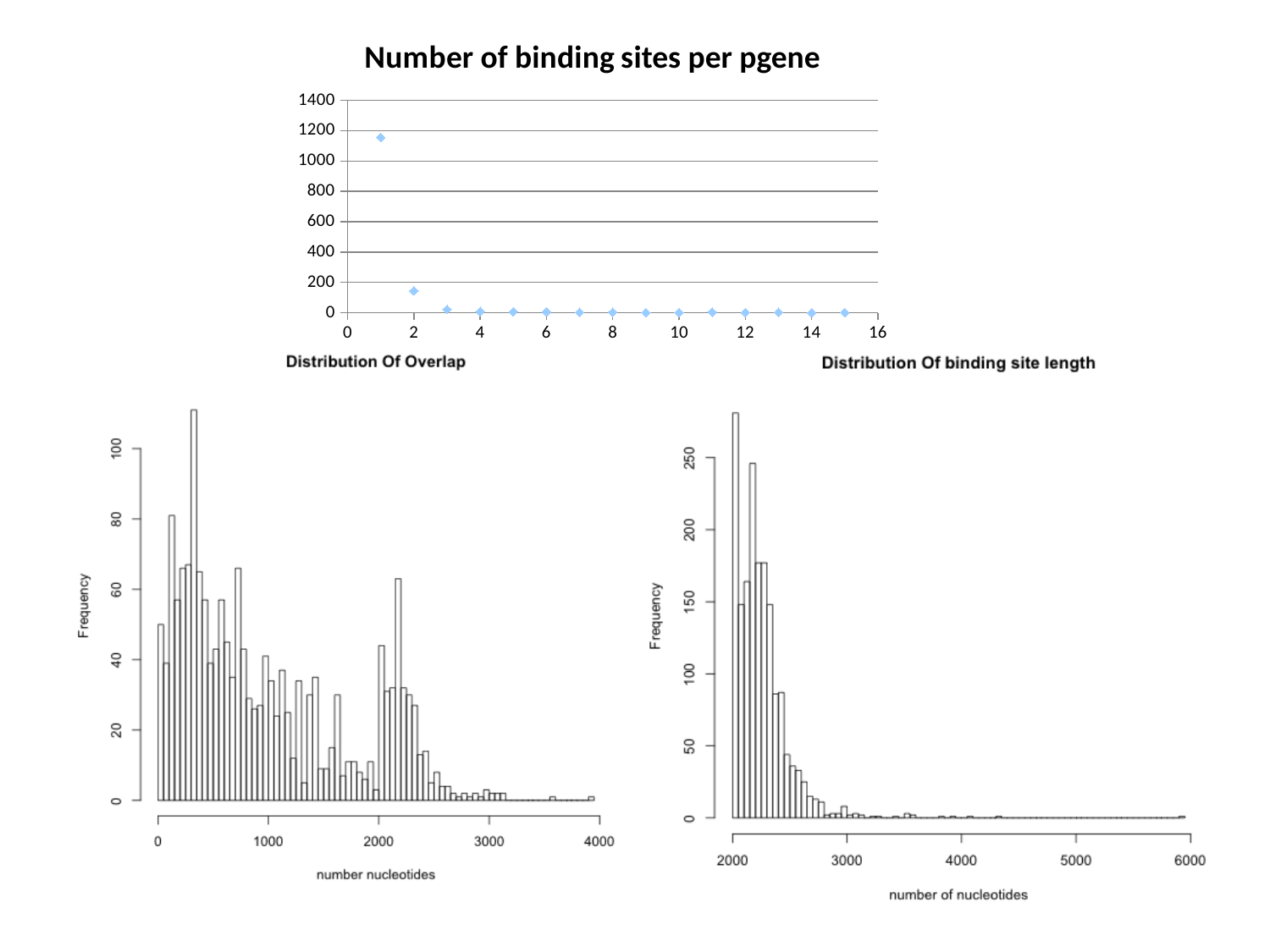
In the 'Distribution Of Overlap' chart, is the tallest bar greater or less than 100? greater In the 'Distribution Of binding site length' chart, is the tallest bar greater or less than 250? greater What kind of chart is the 'Distribution Of Overlap' chart? bar chart What kind of chart is the 'Number of binding sites per pgene' chart? scatter plot In the 'Number of binding sites per pgene' chart, how many data points are plotted? 15 In the 'Number of binding sites per pgene' chart, at which x value is the highest point? 1 What is the y-axis label of the 'Distribution Of Overlap' chart? Frequency In the 'Number of binding sites per pgene' chart, is the value at x = 1 greater or less than 1000? greater In the 'Distribution Of binding site length' chart, do the bar heights generally rise or fall as the number of nucleotides increases? fall In the 'Number of binding sites per pgene' chart, do the values rise or fall as x increases? fall In the 'Number of binding sites per pgene' chart, which has the larger value, x = 1 or x = 2? x = 1